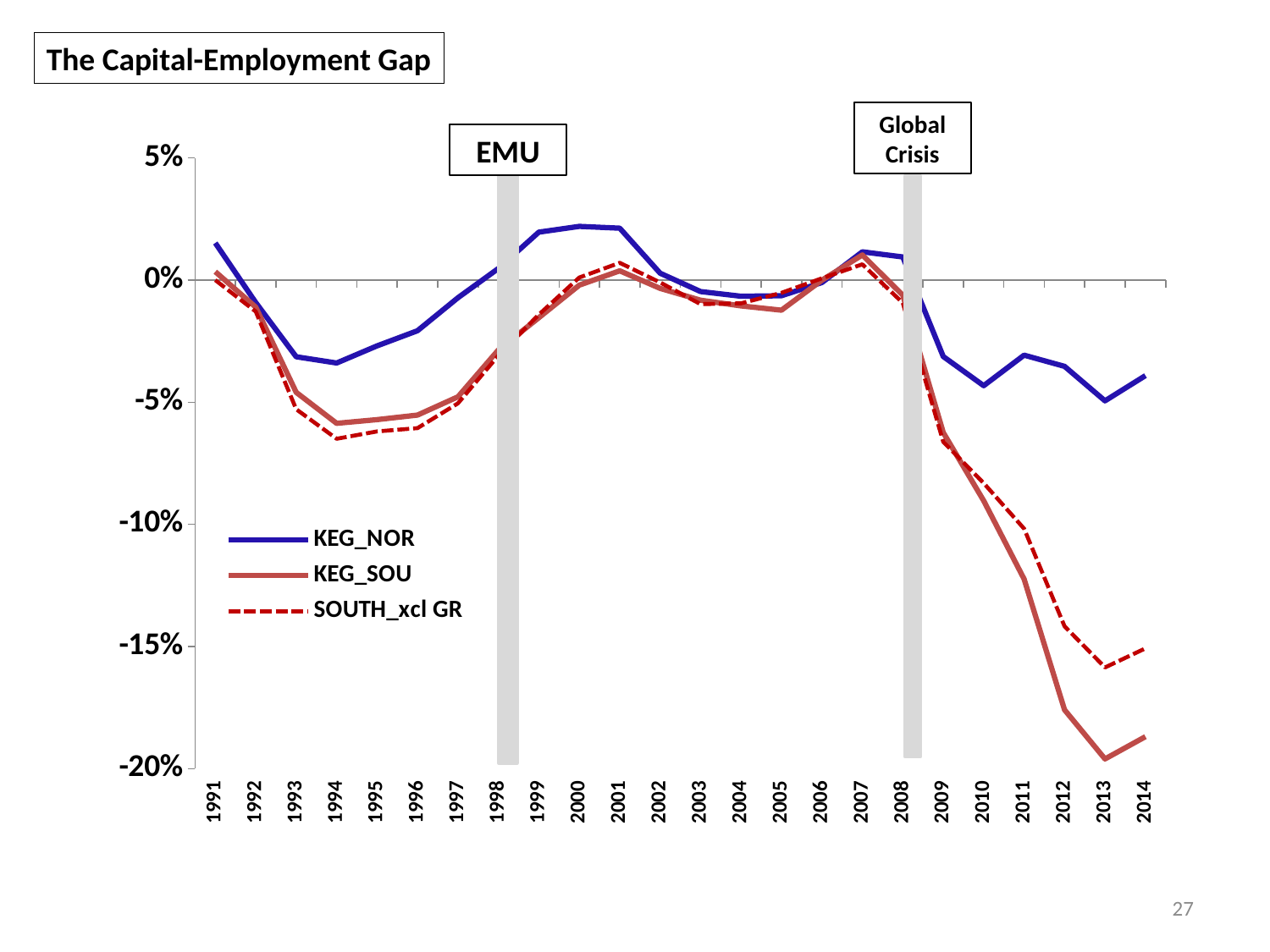
Is the value for KEG_SOU in 1994 greater or less than -5%? less What is the title of the chart? The Capital-Employment Gap Is the value for KEG_SOU in 2013 greater or less than -15%? less Which series has the lowest value in 2013? KEG_SOU Is the value for KEG_NOR in 2010 greater or less than -5%? greater How many series does the legend list? 3 In 2014, which series has a higher value, KEG_SOU or SOUTH_xcl GR? SOUTH_xcl GR What kind of chart is shown on the slide? line chart Does the KEG_SOU line rise or fall from 2008 to 2013? fall How many years are shown on the x axis? 24 In 2013, which series has a higher value, KEG_NOR or KEG_SOU? KEG_NOR